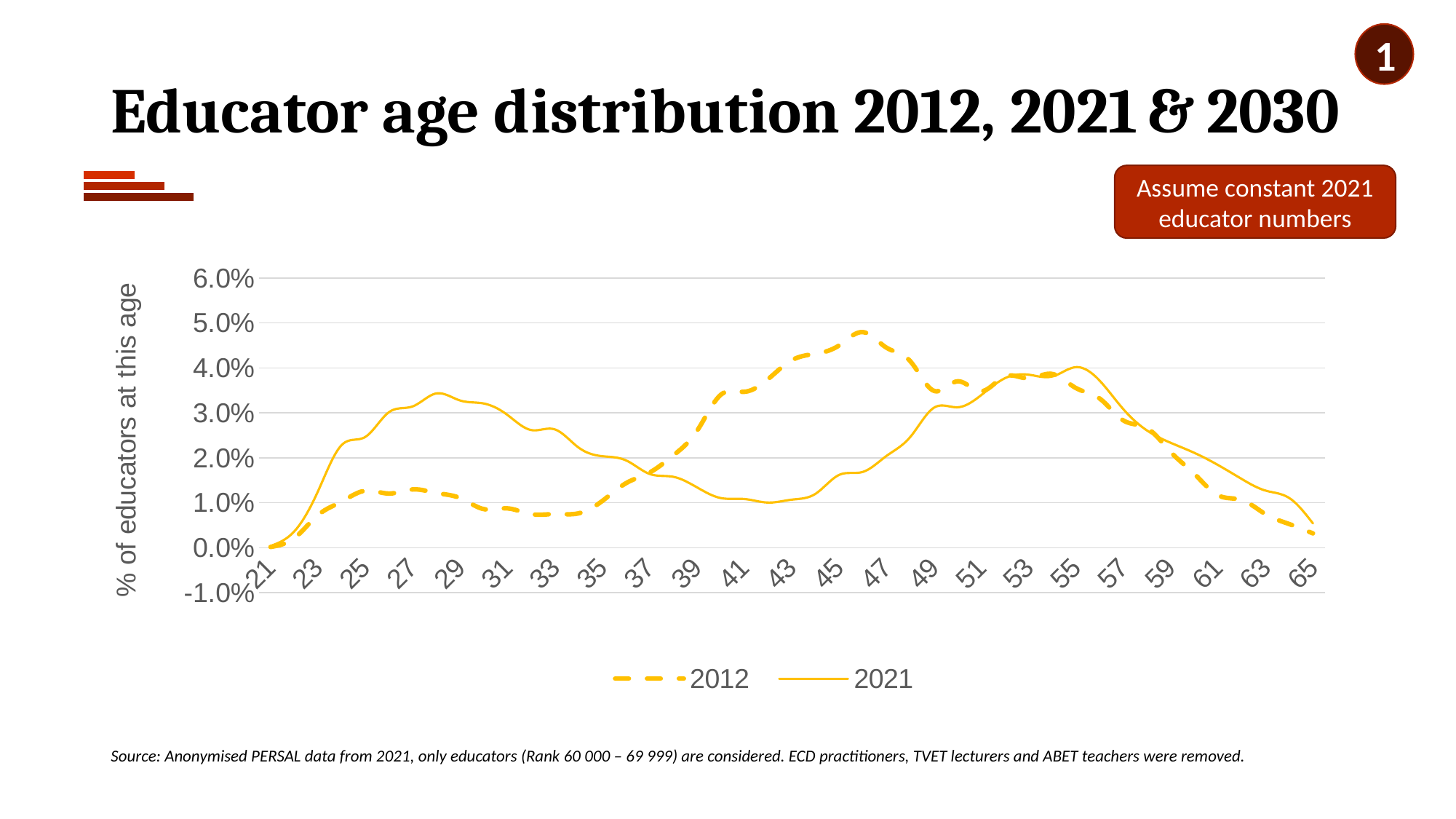
Is the value for the 2021 series at age 29 greater or less than 3.0%? greater Does the 2012 series rise or fall between age 47 and age 65? Fall What are the two series named in the legend? 2012 and 2021 Is the value for the 2012 series at age 47 greater or less than 4.0%? greater What is the label on the vertical axis? % of educators at this age What kind of chart is shown on the slide? Line chart At age 45, which series has the higher value, 2012 or 2021? 2012 Is the value for the 2021 series at age 43 greater or less than 2.0%? less At which age does the 2012 series reach its highest value? 46 How many series does the legend list? 2 At age 25, which series has the higher value, 2012 or 2021? 2021